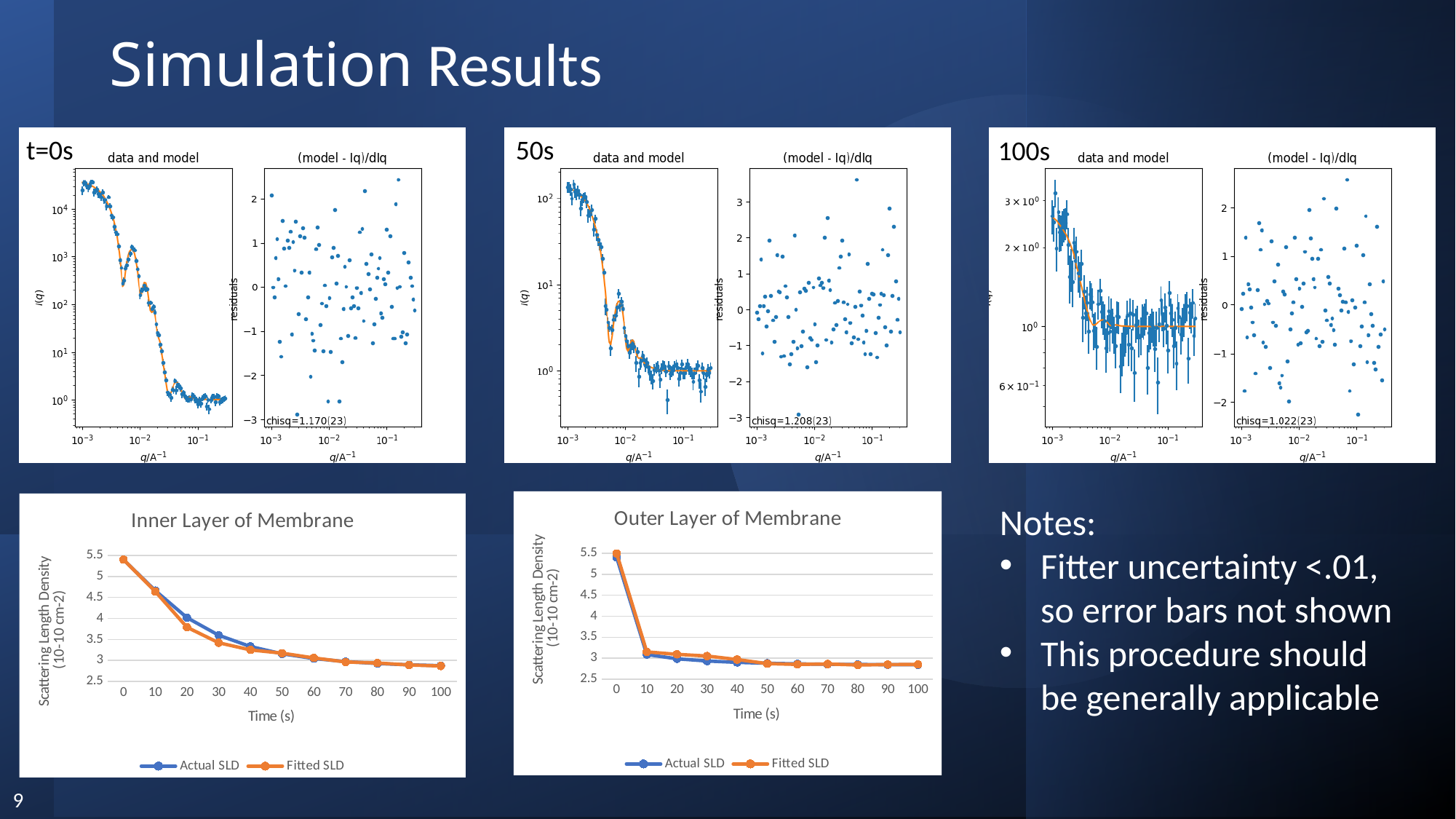
What chisq value is printed on the residuals panel for the 50s simulation? chisq=1.208(23) How many series does the legend of the "Outer Layer of Membrane" chart list? 2 In the "Inner Layer of Membrane" chart, is the Fitted SLD at time 60 greater or less than 3.5? less In the "Inner Layer of Membrane" chart, at which time is the Actual SLD highest? 0 In the "Outer Layer of Membrane" chart, is the Actual SLD at time 10 greater or less than 3.5? less How many time points are plotted for each series in the "Inner Layer of Membrane" chart? 11 What are the two legend entries in the "Outer Layer of Membrane" chart? Actual SLD and Fitted SLD In the "Inner Layer of Membrane" chart, is the Actual SLD at time 0 greater or less than 5? greater In the "Outer Layer of Membrane" chart, do the Fitted SLD values rise or fall as time increases? fall In the "Inner Layer of Membrane" chart, do the Actual SLD values rise or fall as time increases? fall What kind of chart is the "Inner Layer of Membrane" chart? line chart In the "Inner Layer of Membrane" chart, at time 20, which is larger: Actual SLD or Fitted SLD? Actual SLD